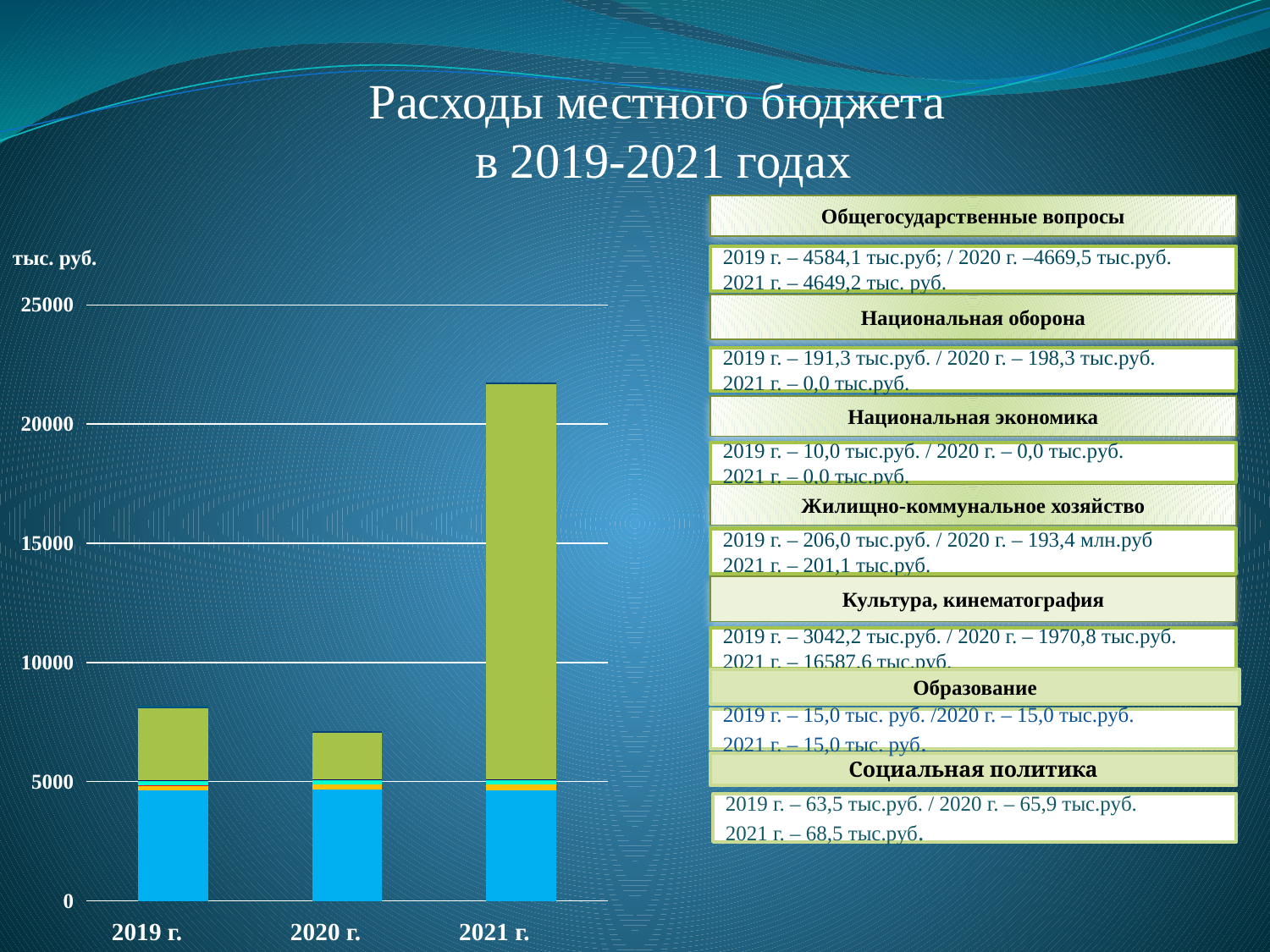
Does the total bar height rise or fall from 2019 г. to 2020 г.? falls Is the total height of the bar for 2021 г. greater or less than 20000? greater How many categories (years) are plotted on the x axis of the chart? 3 What kind of chart is shown on the slide? bar chart Is the total height of the bar for 2020 г. greater or less than 5000? greater Which year has the tallest bar in the chart? 2021 г. What is the title of the slide containing the chart? Расходы местного бюджета в 2019-2021 годах Does the total bar height rise or fall from 2020 г. to 2021 г.? rises Is the total height of the bar for 2019 г. greater or less than 10000? less What unit label is shown above the y axis of the chart? тыс. руб. Which year has the shortest bar in the chart? 2020 г. Which bar is taller, 2019 г. or 2020 г.? 2019 г.